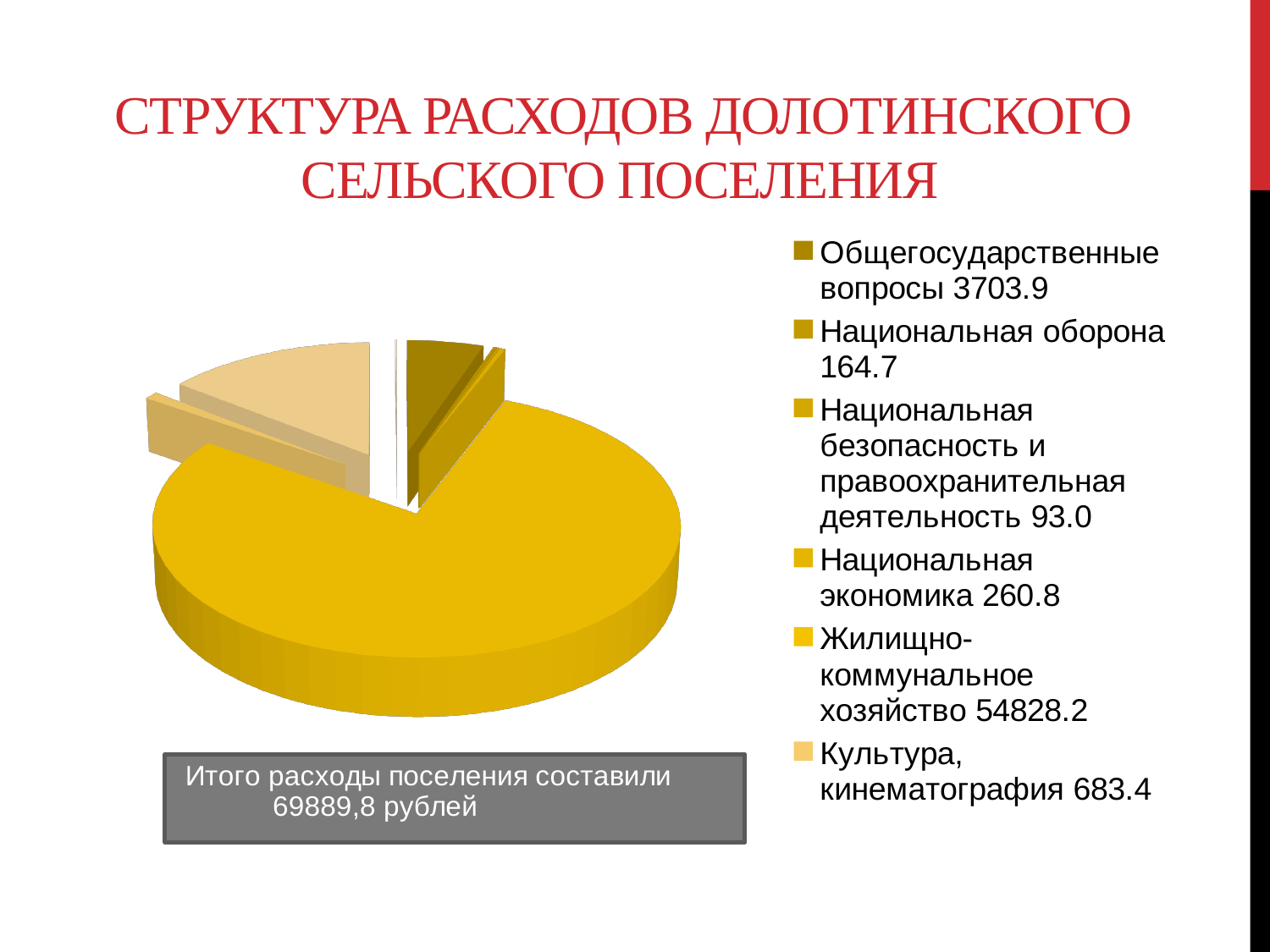
What value is shown for Культура, кинематография? 683.4 What is the difference between the values for Общегосударственные вопросы and Национальная экономика? 3443.1 What value is shown for Жилищно-коммунальное хозяйство in the legend? 54828.2 Which is larger: Культура, кинематография or Национальная оборона? Культура, кинематография What is the difference between the values for Культура, кинематография and Национальная оборона? 518.7 According to the text box below the chart, what were the total expenses of the settlement? 69889,8 рублей What value is shown for Национальная экономика? 260.8 What value is shown for Национальная оборона? 164.7 Which category has the largest slice of the pie? Жилищно-коммунальное хозяйство What type of chart is shown on the slide? Pie chart